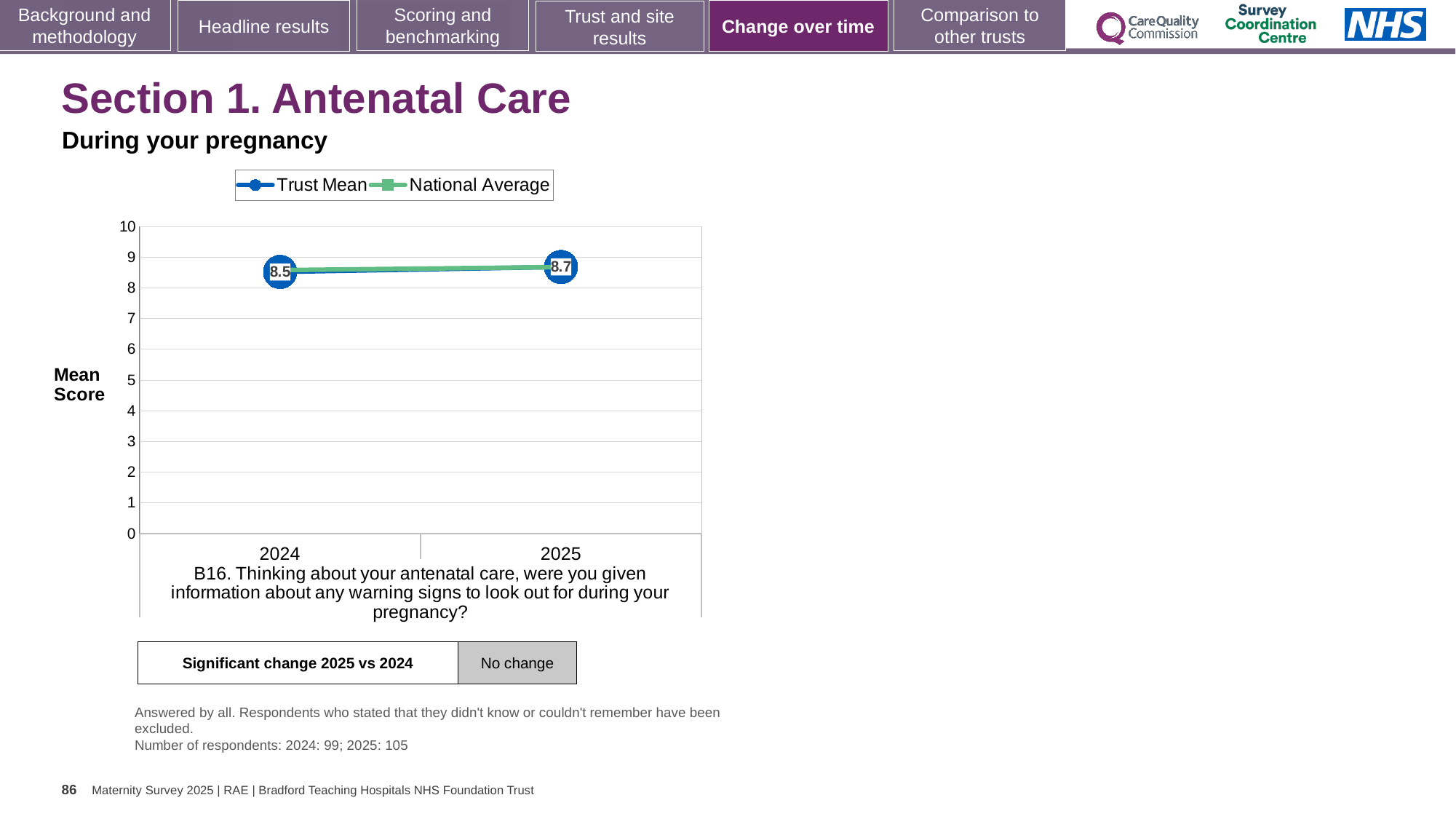
What is the Trust Mean score for 2024? 8.5 How many years are plotted on the x axis? 2 Is the National Average for 2024 greater or less than 8? greater What kind of chart is shown on the slide? line chart Is the Trust Mean score for 2025 greater or less than 8? greater In which year is the Trust Mean score lower? 2024 What is the Trust Mean score for 2025? 8.7 How many series does the legend list? 2 Does the Trust Mean rise or fall from 2024 to 2025? rise What does the 'Significant change 2025 vs 2024' box say? No change In which year is the Trust Mean score higher? 2025 By how much did the Trust Mean score change from 2024 to 2025? 0.2